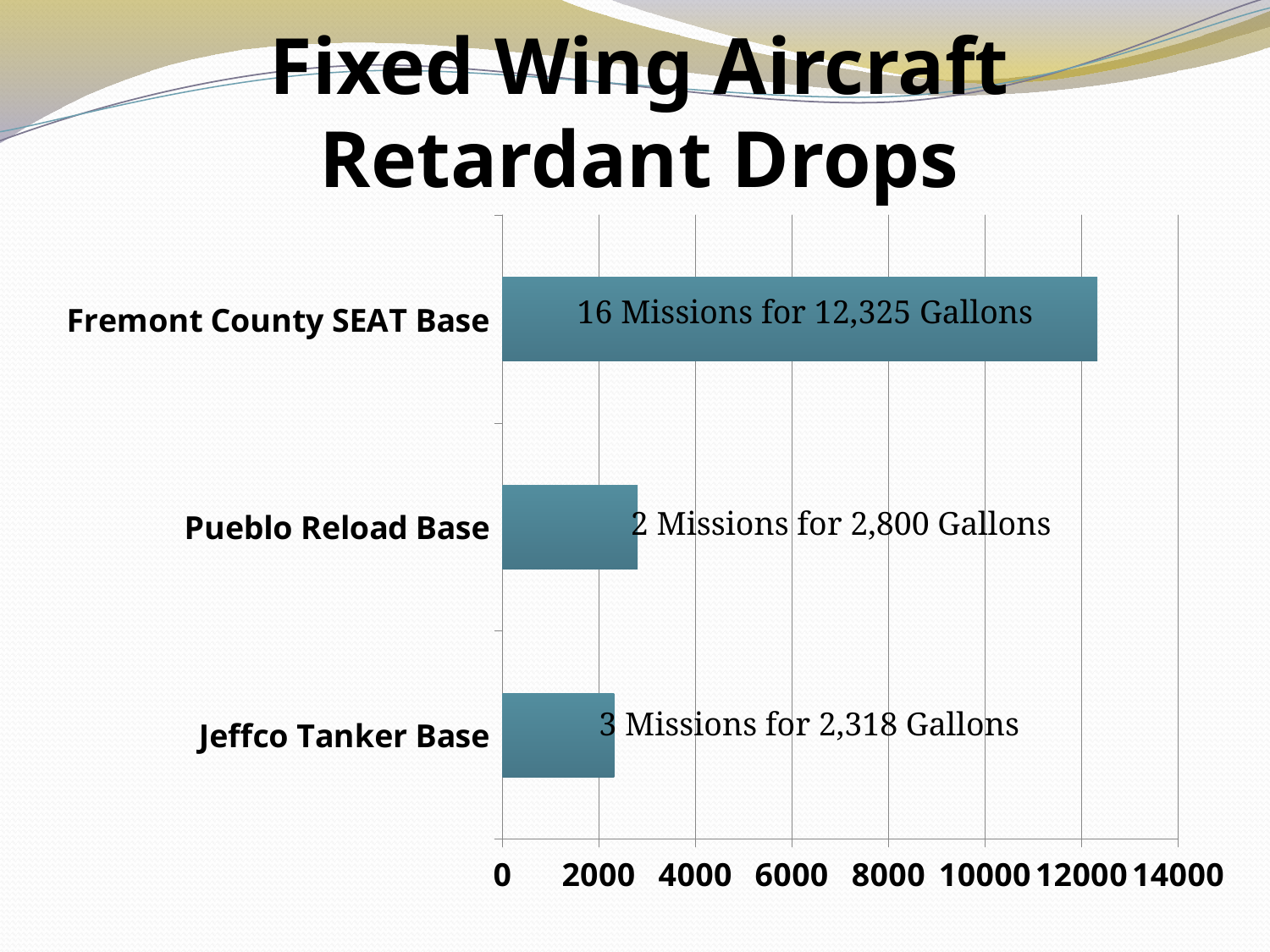
What is the title of the chart on the slide? Fixed Wing Aircraft Retardant Drops How many missions were flown from the Fremont County SEAT Base? 16 Missions What is the difference in gallons between the Fremont County SEAT Base and the Pueblo Reload Base? 9,525 Gallons What kind of chart is shown on the slide? bar chart Which base has the lowest number of gallons dropped? Jeffco Tanker Base Which base has the highest number of gallons dropped? Fremont County SEAT Base How many gallons were dropped from the Fremont County SEAT Base? 12,325 Gallons How many bases (categories) are shown in the chart? 3 How many missions were flown from the Pueblo Reload Base? 2 Missions Is the value for Fremont County SEAT Base greater or less than 10000? greater How many gallons were dropped from the Jeffco Tanker Base? 2,318 Gallons Which base dropped more gallons, Pueblo Reload Base or Jeffco Tanker Base? Pueblo Reload Base